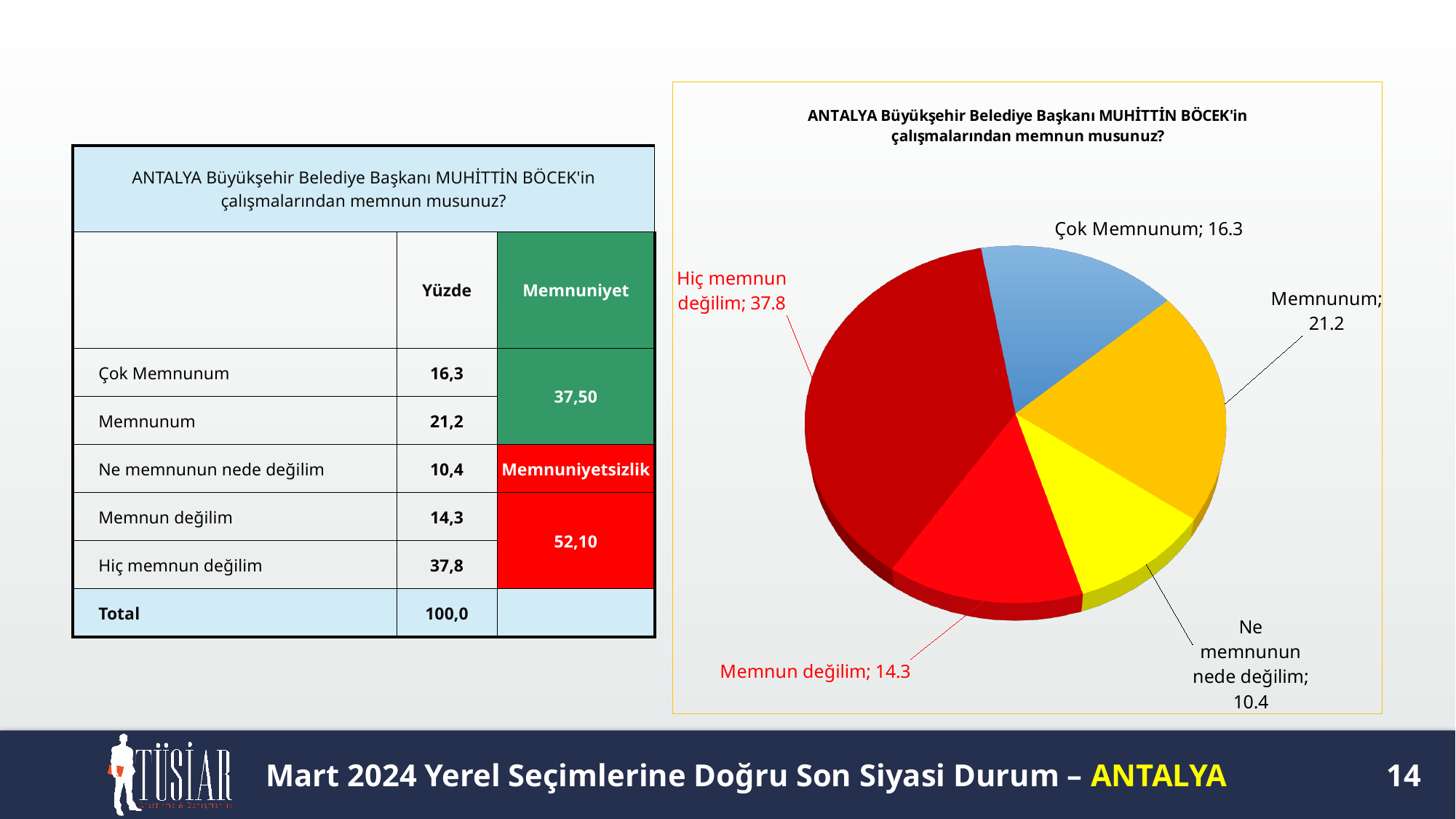
What is the value for "Memnun değilim" in the pie chart? 14.3 What is the value for "Çok Memnunum" in the pie chart? 16.3 What kind of chart is shown on the slide? pie chart What is the value for "Hiç memnun değilim" in the pie chart? 37.8 What is the difference between the values for "Hiç memnun değilim" and "Memnunum" in the pie chart? 16.6 What is the value for "Ne memnunun nede değilim" in the pie chart? 10.4 Which is larger in the pie chart, "Memnunum" or "Çok Memnunum"? Memnunum How many slices does the pie chart have? 5 What colour is the "Çok Memnunum" slice in the pie chart? blue What share of the pie does "Memnunum" represent? 21.2 Which category has the largest slice in the pie chart? Hiç memnun değilim Which category has the smallest slice in the pie chart? Ne memnunun nede değilim